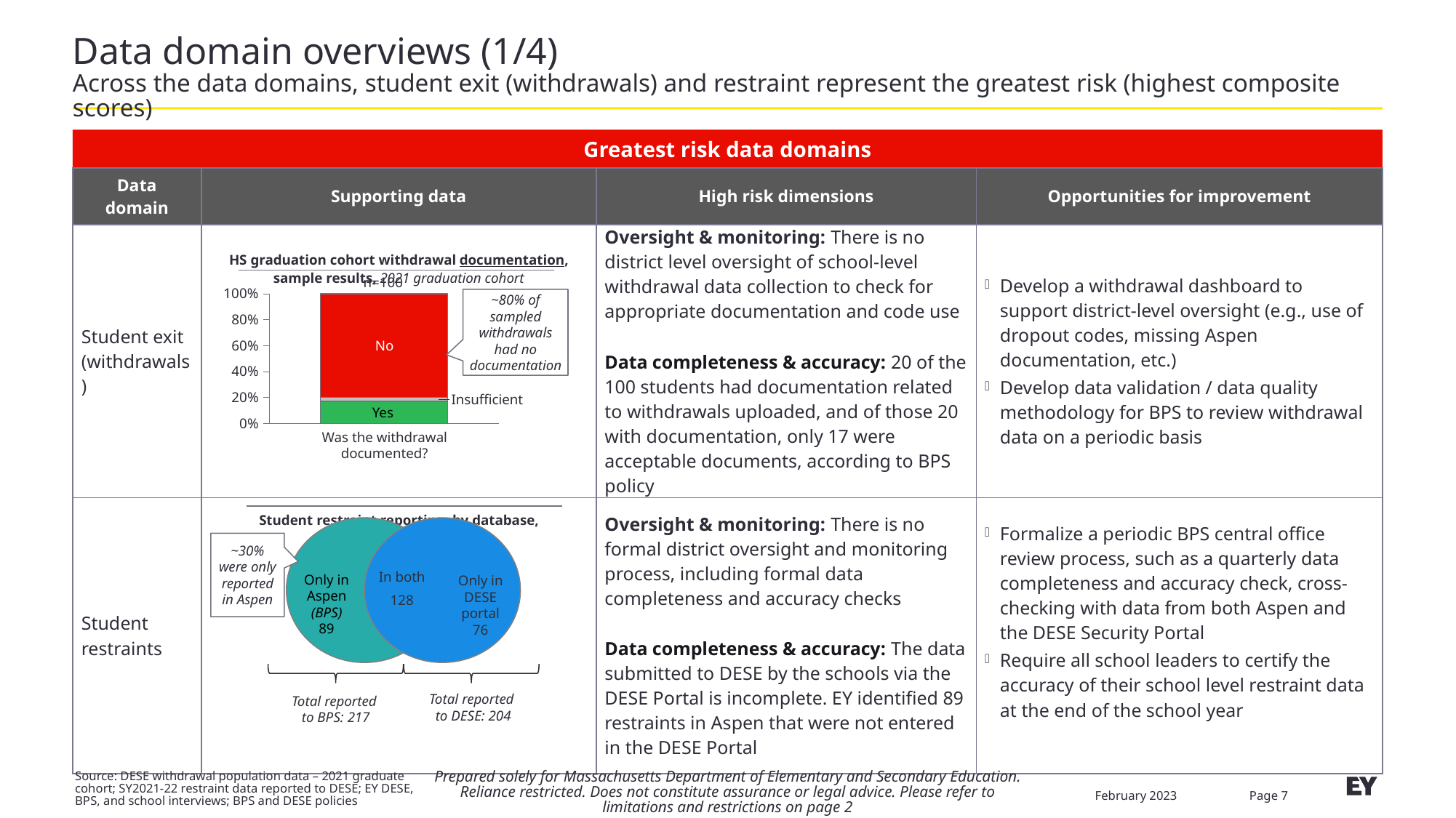
In the withdrawal documentation bar chart, which segment is the largest? No In the withdrawal documentation bar chart, which segment is the smallest? Insufficient In the withdrawal documentation bar chart, which is larger, the 'No' segment or the 'Yes' segment? No In the student restraint reporting Venn diagram, how many restraints were reported in both databases? 128 In the withdrawal documentation bar chart, what colour is the 'No' segment? red In the withdrawal documentation bar chart, what question is written as the x-axis label? Was the withdrawal documented? In the student restraint reporting Venn diagram, how many restraints were only in the DESE portal? 76 What kind of chart is shown in the Supporting data cell for Student exit (withdrawals)? bar chart In the student restraint reporting Venn diagram, what is the difference between the number in both databases and the number only in Aspen? 39 In the withdrawal documentation bar chart, is the share for 'No' greater or less than 60%? greater In the withdrawal documentation bar chart, how many segments make up the stacked bar? 3 In the withdrawal documentation bar chart, is the share for 'Yes' greater or less than 40%? less